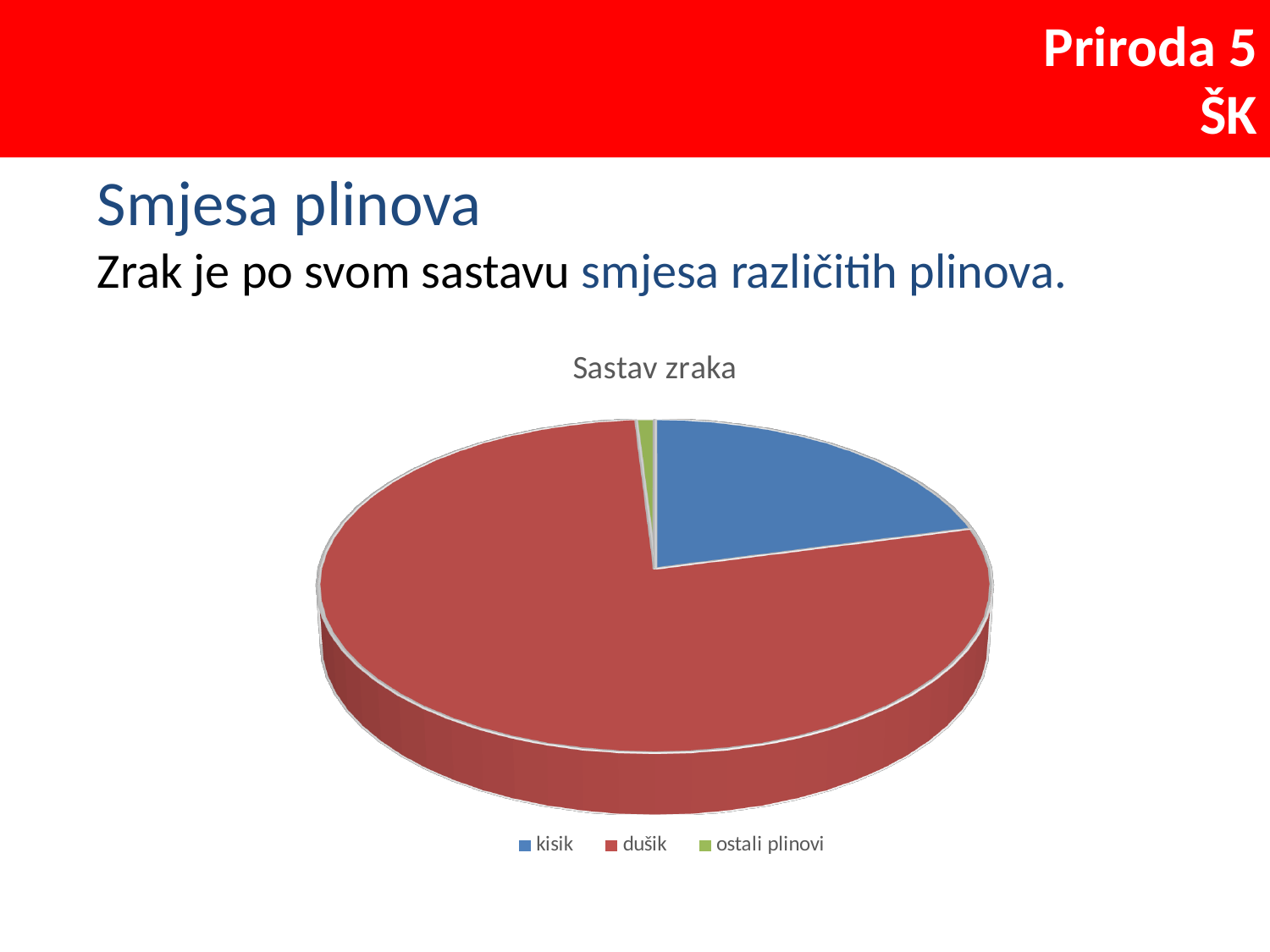
Which category is shown in blue in the pie chart? kisik Which category has the smallest slice of the pie? ostali plinovi What is the title of the chart? Sastav zraka What kind of chart is shown on the slide? pie chart Which category has the largest slice of the pie? dušik How many slices does the pie chart have? 3 Which slice is larger, kisik or ostali plinovi? kisik Which slice is larger, kisik or dušik? dušik How many entries does the legend list? 3